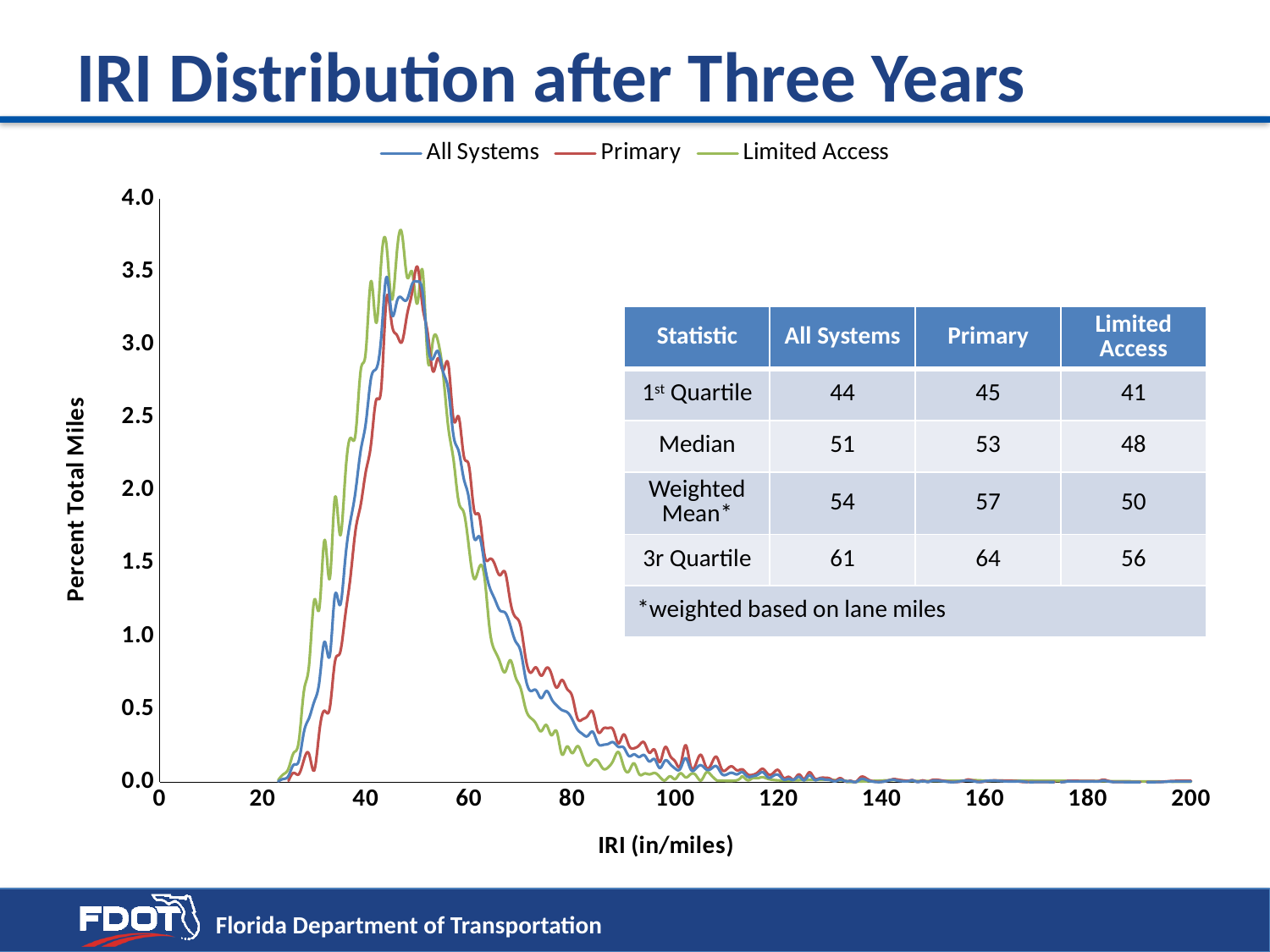
Is the peak value of the Limited Access series greater or less than 3.5? greater Is the value for Primary at IRI 30 greater or less than 0.5? less What is the label of the chart's x axis? IRI (in/miles) Do the values of the All Systems series rise or fall as IRI increases from 60 to 200? fall What are the three series named in the chart's legend? All Systems, Primary, Limited Access Do the values of the Limited Access series rise or fall as IRI increases from 20 to 40? rise Is the value for Primary at IRI 120 greater or less than 0.5? less How many series does the chart's legend list? 3 What kind of chart is shown on the slide? line chart Which series reaches the highest peak value on the chart? Limited Access